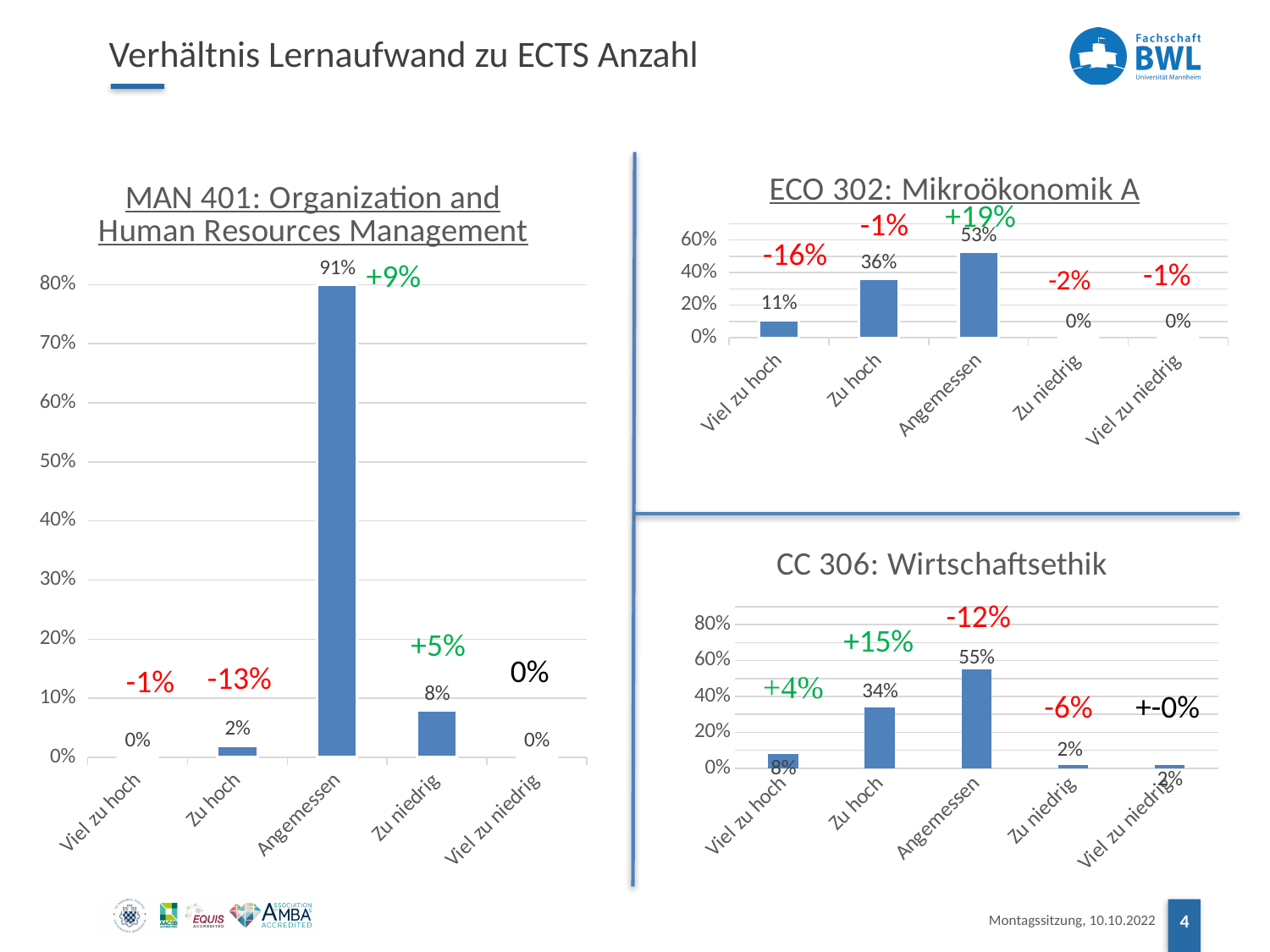
What kind of chart is the CC 306: Wirtschaftsethik chart? Bar chart In the ECO 302: Mikroökonomik A chart, what is the difference between the values for Angemessen and Zu hoch? 17% In the ECO 302: Mikroökonomik A chart, what is the value for Zu hoch? 36% In the CC 306: Wirtschaftsethik chart, which is larger, the value for Zu hoch or the value for Viel zu hoch? Zu hoch In the ECO 302: Mikroökonomik A chart, which category has the highest value? Angemessen In the MAN 401: Organization and Human Resources Management chart, what is the value for Zu niedrig? 8% In the MAN 401: Organization and Human Resources Management chart, what is the value for Angemessen? 91% How many categories are shown on the x axis of the MAN 401: Organization and Human Resources Management chart? 5 In the ECO 302: Mikroökonomik A chart, what is the value for Viel zu hoch? 11% In the CC 306: Wirtschaftsethik chart, what is the value for Zu hoch? 34% In the CC 306: Wirtschaftsethik chart, which category has the highest value? Angemessen In the CC 306: Wirtschaftsethik chart, what is the value for Angemessen? 55%